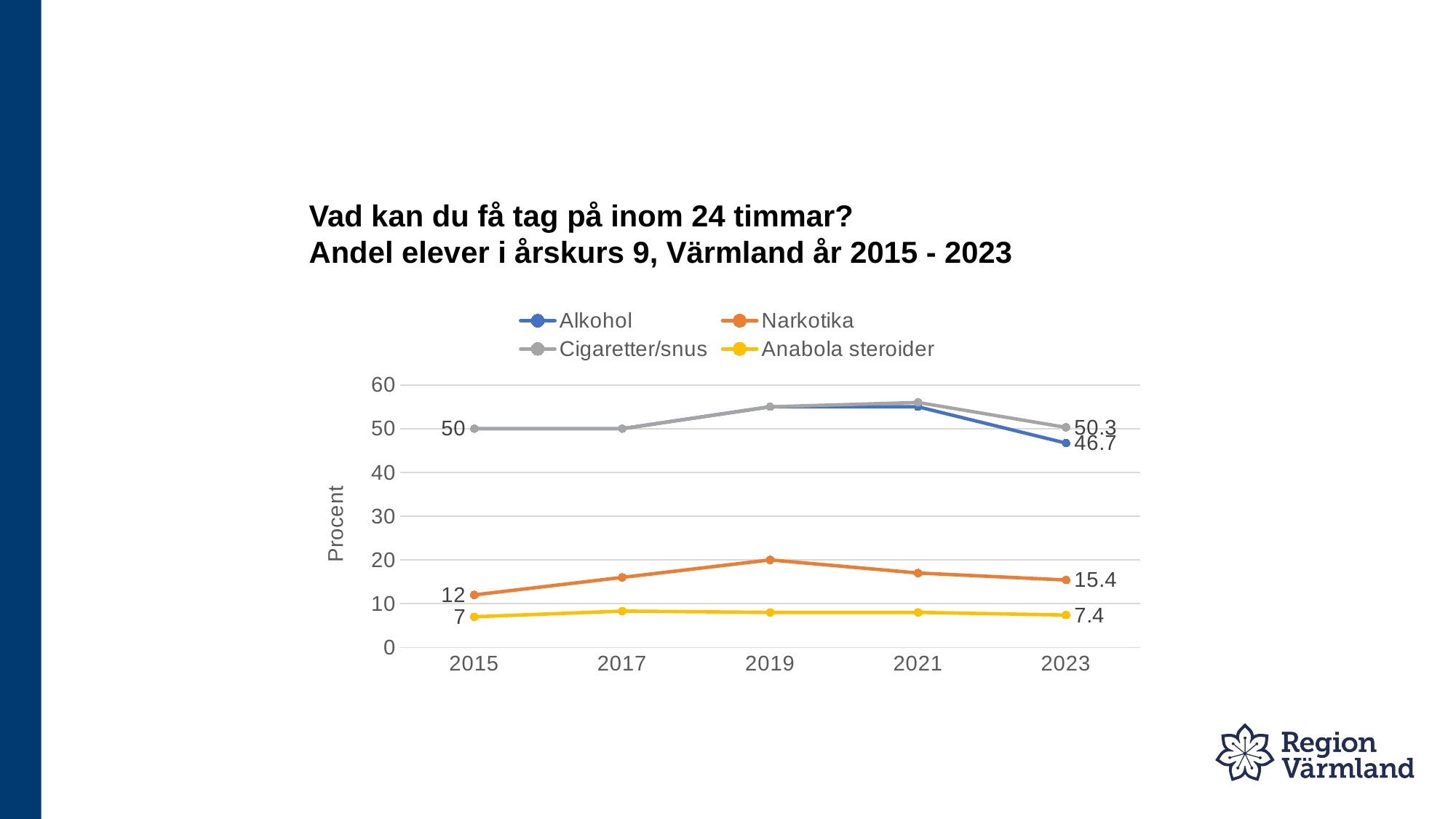
What is the value for Narkotika in 2015? 12 Which series has the lowest value in 2023? Anabola steroider How many years are shown on the x axis? 5 What is the value for Anabola steroider in 2015? 7 What is the value for Narkotika in 2023? 15.4 What kind of chart is shown on the slide? line chart In 2023, which is larger: Alkohol or Cigaretter/snus? Cigaretter/snus How many series does the legend list? 4 What is the value for Alkohol in 2023? 46.7 What is the value for Cigaretter/snus in 2023? 50.3 What is the difference between the Narkotika values in 2023 and 2015? 3.4 Is the value for Alkohol in 2019 greater or less than 50? greater